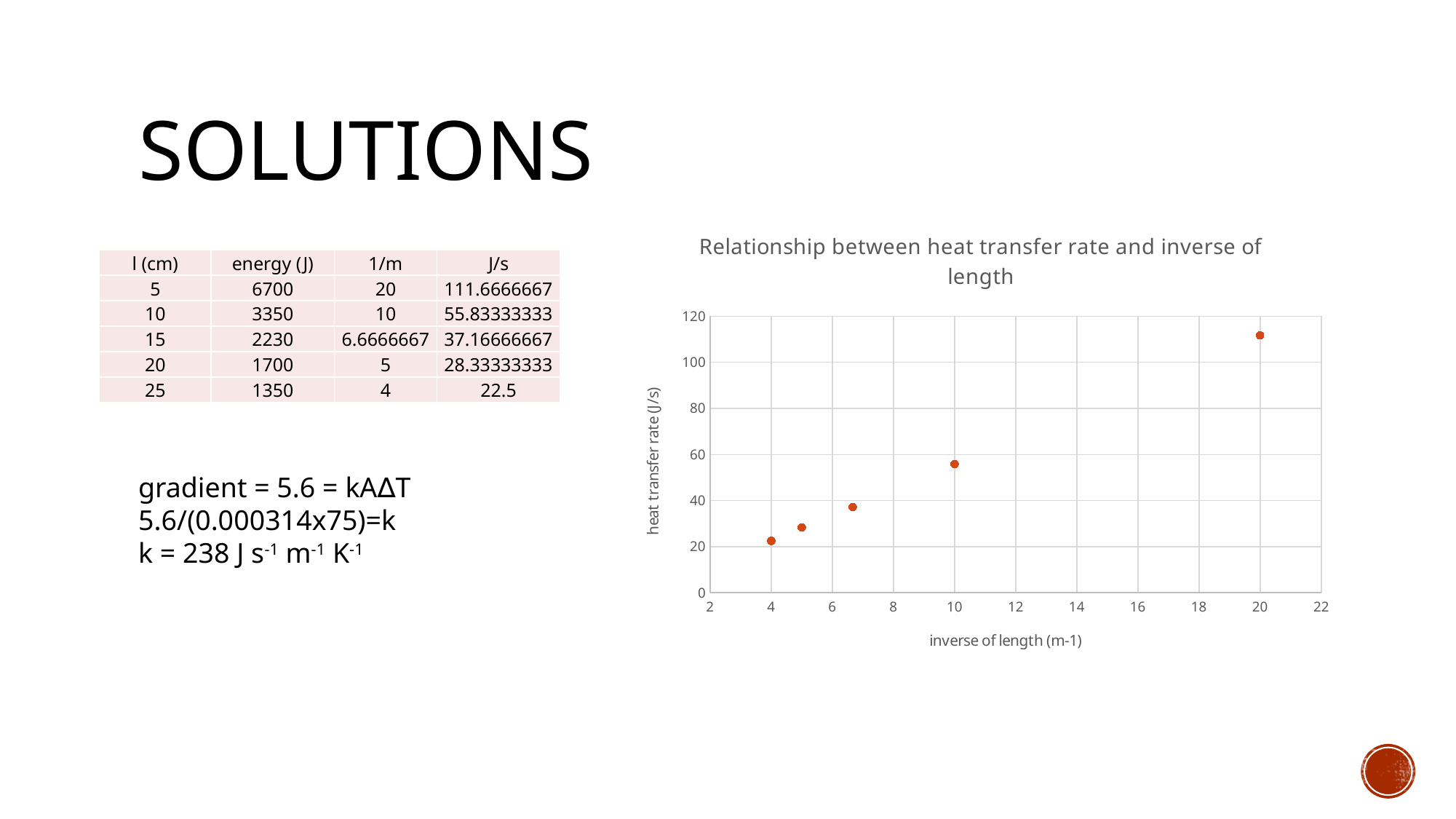
At which inverse of length value is the heat transfer rate lowest? 4 Is the heat transfer rate at inverse of length 4 greater or less than 20? greater At which inverse of length value is the heat transfer rate highest? 20 Is the heat transfer rate at inverse of length 20 greater or less than 100? greater What kind of chart is shown on the slide? scatter chart Is the heat transfer rate at inverse of length 10 greater or less than 60? less What is the title of the chart? Relationship between heat transfer rate and inverse of length Which has the larger heat transfer rate: the point at inverse of length 10 or the point at inverse of length 4? inverse of length 10 Does the heat transfer rate rise or fall as the inverse of length increases? rises How many data points are plotted on the chart? 5 What is the label on the y axis of the chart? heat transfer rate (J/s)